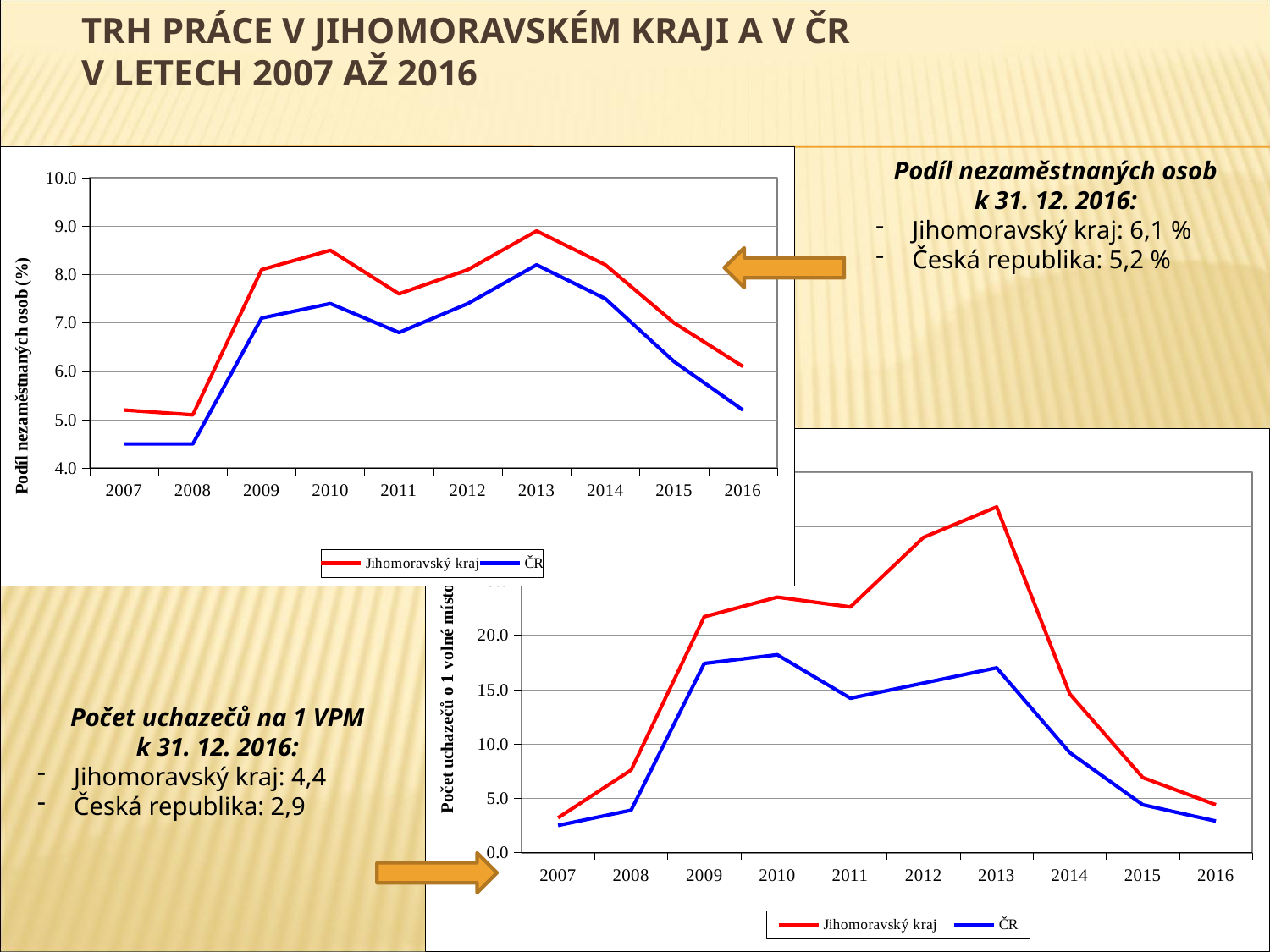
In the top-left chart, which series has the higher value in 2013, Jihomoravský kraj or ČR? Jihomoravský kraj In the top-left chart, is the value for Jihomoravský kraj in 2010 greater or less than 8.0? greater In the bottom-right chart, is the value for Jihomoravský kraj in 2012 greater or less than 25.0? greater According to the slide, what is the share of unemployed persons (Podíl nezaměstnaných osob) in Jihomoravský kraj as of 31. 12. 2016? 6,1 % According to the slide, what is the difference between the number of applicants per vacancy (Počet uchazečů na 1 VPM) in Jihomoravský kraj and in Česká republika as of 31. 12. 2016? 1,5 In the top-left chart, does the Jihomoravský kraj line rise or fall from 2013 to 2016? fall In the top-left chart, in which year does the Jihomoravský kraj line reach its highest value? 2013 In the top-left chart, is the value for ČR in 2015 greater or less than 7.0? less What kind of chart is the top-left chart on the slide? line chart How many series does the legend of the bottom-right chart list? 2 In the bottom-right chart, in which year does the Jihomoravský kraj line reach its highest value? 2013 How many years are shown on the x axis of the top-left chart? 10